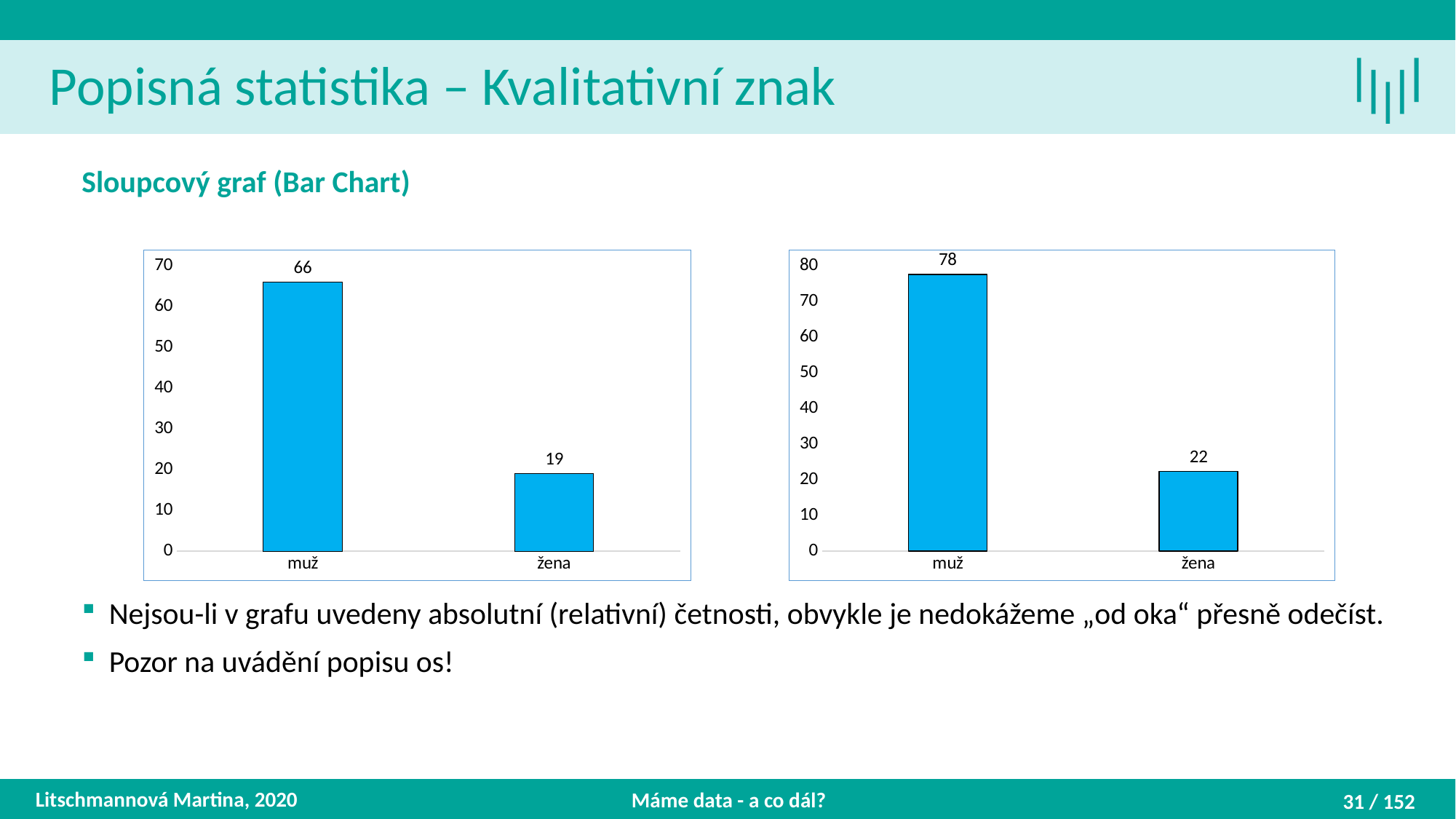
In the left chart, what is the difference between the values for muž and žena? 47 In the left chart, what is the value for žena? 19 In the right chart, what is the difference between the values for muž and žena? 56 In the right chart, is the value for muž greater or less than 70? greater In the right chart, what is the value for muž? 78 How many categories are shown in the left chart? 2 In the left chart, which category has the highest value? muž In the left chart, what is the value for muž? 66 What is the highest tick value on the vertical axis of the right chart? 80 In the right chart, what is the value for žena? 22 In the right chart, which category has the lowest value? žena What kind of chart is the right chart? bar chart